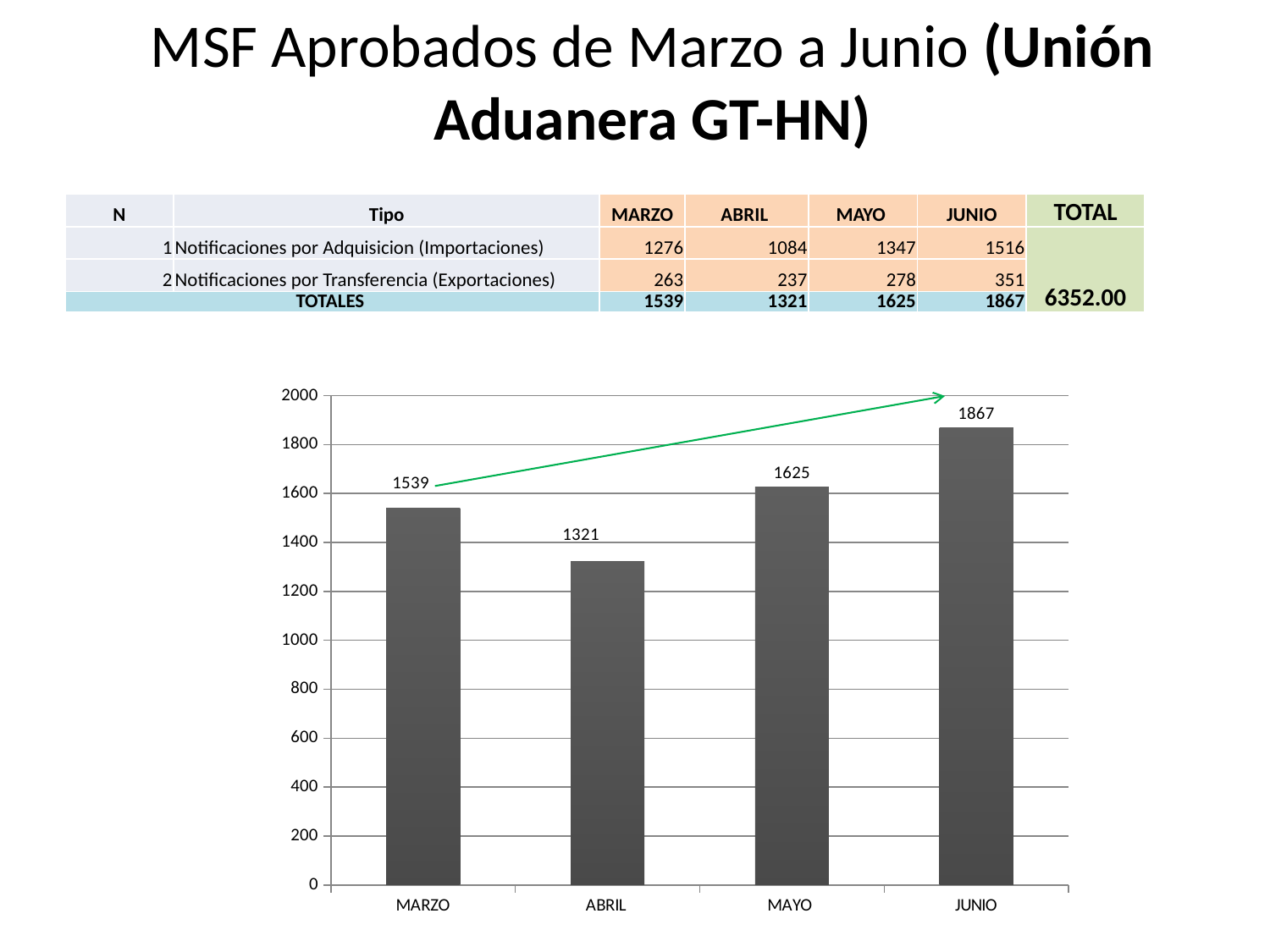
Which month has the highest value in the bar chart? JUNIO What is the value for JUNIO in the bar chart? 1867 What kind of chart is shown on the slide? bar chart What is the value for MAYO in the bar chart? 1625 What is the difference between the values for MAYO and ABRIL in the bar chart? 304 What is the value for MARZO in the bar chart? 1539 What is the value for ABRIL in the bar chart? 1321 How many months are shown on the x axis of the bar chart? 4 What is the difference between the values for JUNIO and MARZO in the bar chart? 328 Which month has the lowest value in the bar chart? ABRIL Is the value for ABRIL in the bar chart greater or less than 1400? less Which is larger in the bar chart, the value for MARZO or the value for MAYO? MAYO